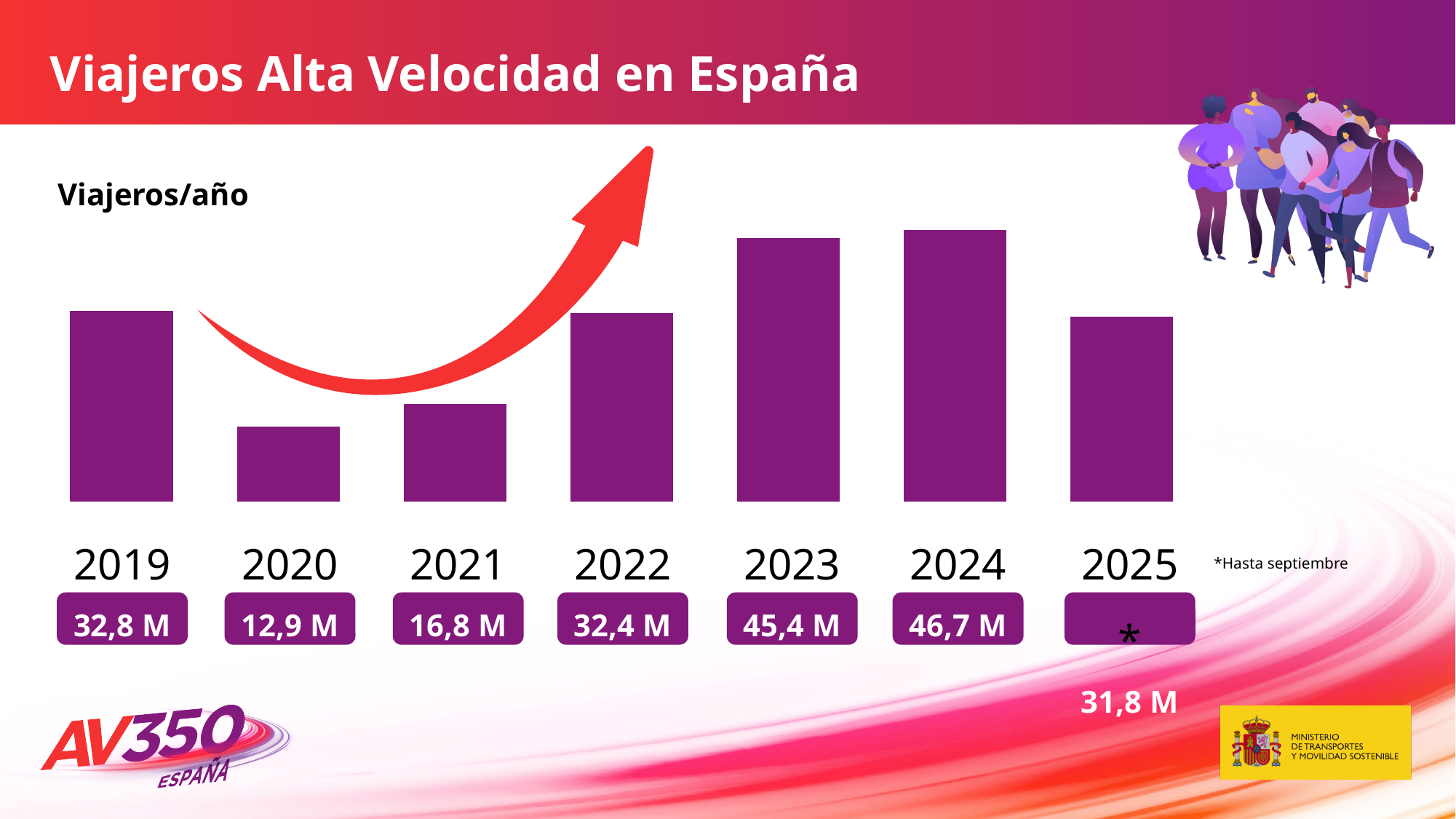
Which is larger, the value for 2022 or the value for 2023? 2023 How many years are shown on the chart? 7 What is the value for 2019? 32,8 M What is the value shown for 2025 (hasta septiembre)? 31,8 M What is the value for 2023? 45,4 M What kind of chart is shown on the slide? bar chart What is the difference between the values for 2019 and 2020? 19,9 M Which year has the lowest value? 2020 What is the value for 2020? 12,9 M Which year has the highest value? 2024 Do the values rise or fall from 2020 to 2024? rise What is the difference between the values for 2024 and 2023? 1,3 M